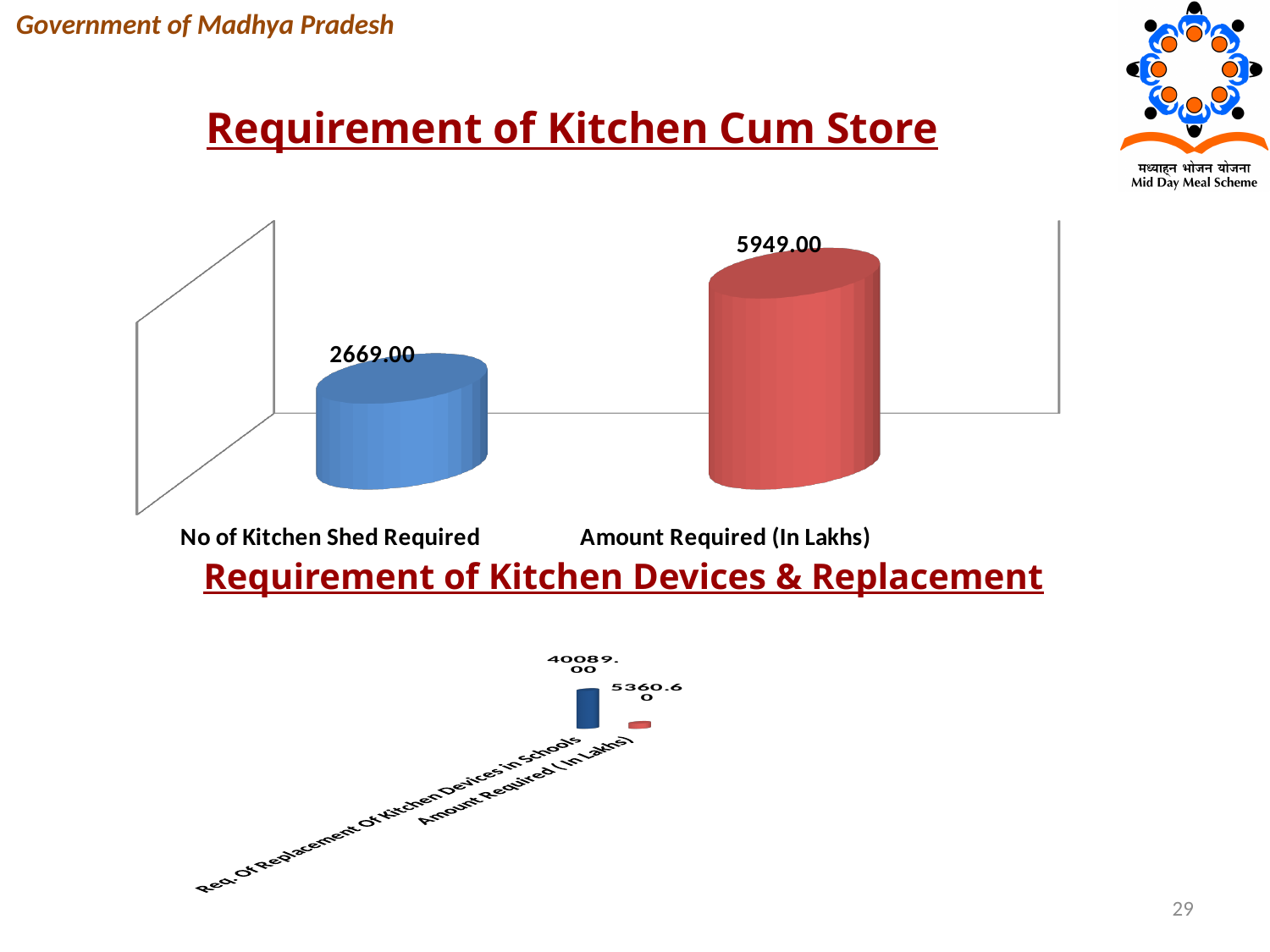
In the 'Requirement of Kitchen Cum Store' chart, how many categories are plotted? 2 In the 'Requirement of Kitchen Devices & Replacement' chart, what is the value for Amount Required (In Lakhs)? 5360.60 In the 'Requirement of Kitchen Devices & Replacement' chart, what is the value for Req. Of Replacement Of Kitchen Devices in Schools? 40089.00 What type of chart is the 'Requirement of Kitchen Cum Store' chart? Bar chart How many charts are shown on the slide? 2 In the 'Requirement of Kitchen Cum Store' chart, which category has the higher value? Amount Required (In Lakhs) In the 'Requirement of Kitchen Cum Store' chart, what is the value for Amount Required (In Lakhs)? 5949.00 In the 'Requirement of Kitchen Devices & Replacement' chart, what is the difference between Req. Of Replacement Of Kitchen Devices in Schools and Amount Required (In Lakhs)? 34728.40 In the 'Requirement of Kitchen Cum Store' chart, what is the difference between Amount Required (In Lakhs) and No of Kitchen Shed Required? 3280.00 In the 'Requirement of Kitchen Devices & Replacement' chart, which category has the lower value? Amount Required (In Lakhs) In the 'Requirement of Kitchen Cum Store' chart, what is the value for No of Kitchen Shed Required? 2669.00 In the 'Requirement of Kitchen Cum Store' chart, what colour is the bar for No of Kitchen Shed Required? Blue